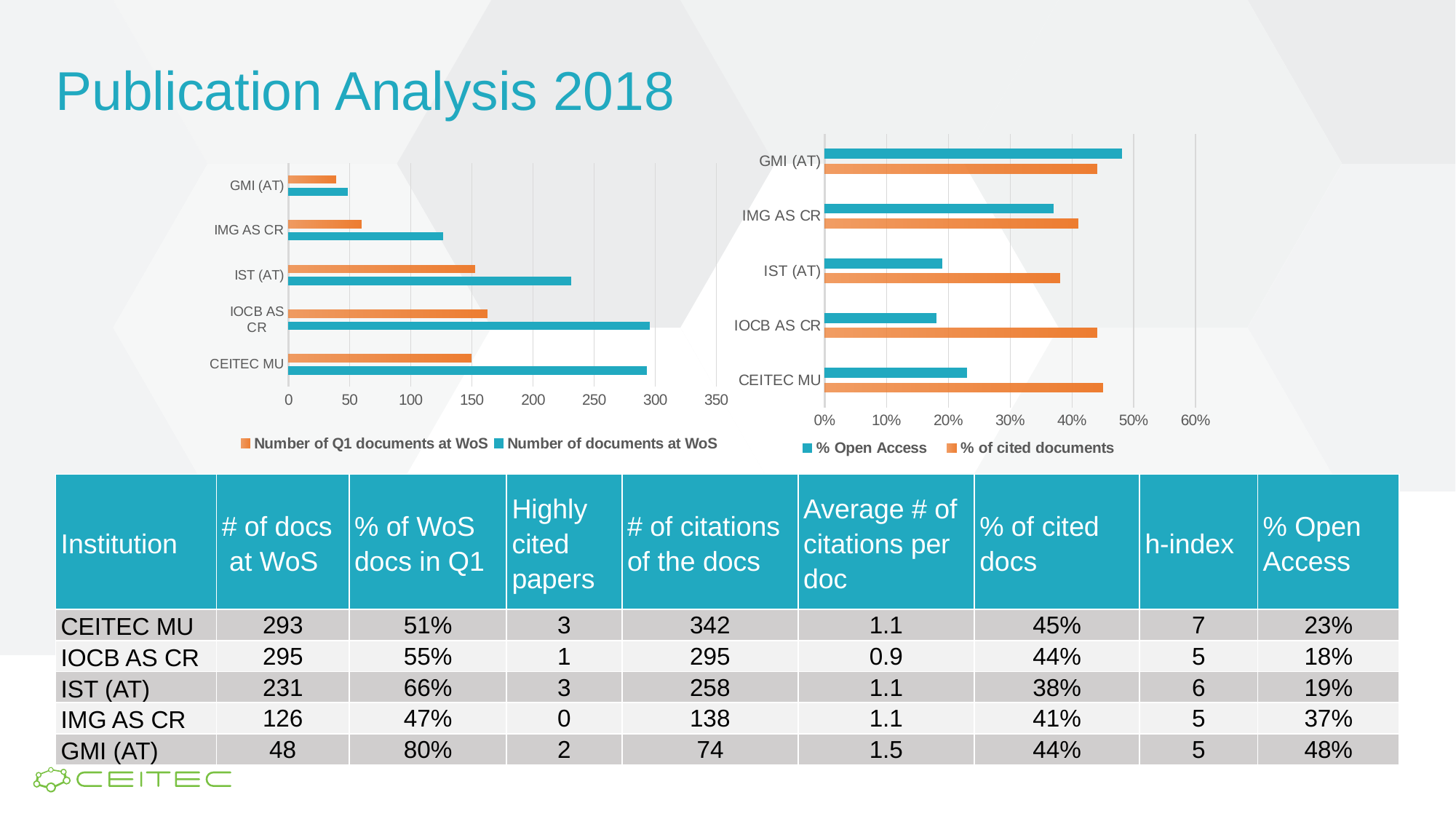
On the left chart, is the number of documents at WoS for IMG AS CR greater or less than 150? less On the right chart, which series is shown in orange? % of cited documents On the left chart, is the number of documents at WoS for IST (AT) greater or less than 200? greater On the left chart, which institution has the lowest number of Q1 documents at WoS? GMI (AT) How many series does the legend of the right chart list? 2 On the left chart, which institution has more documents at WoS, IST (AT) or IMG AS CR? IST (AT) On the left chart, which institution has the lowest number of documents at WoS? GMI (AT) On the right chart, is the % Open Access for IOCB AS CR greater or less than 20%? less On the right chart, which institution has the highest % Open Access? GMI (AT) What kind of chart is the left chart showing the number of documents at WoS? bar chart How many institutions are shown on the left chart? 5 On the right chart, which has the larger % Open Access, GMI (AT) or CEITEC MU? GMI (AT)